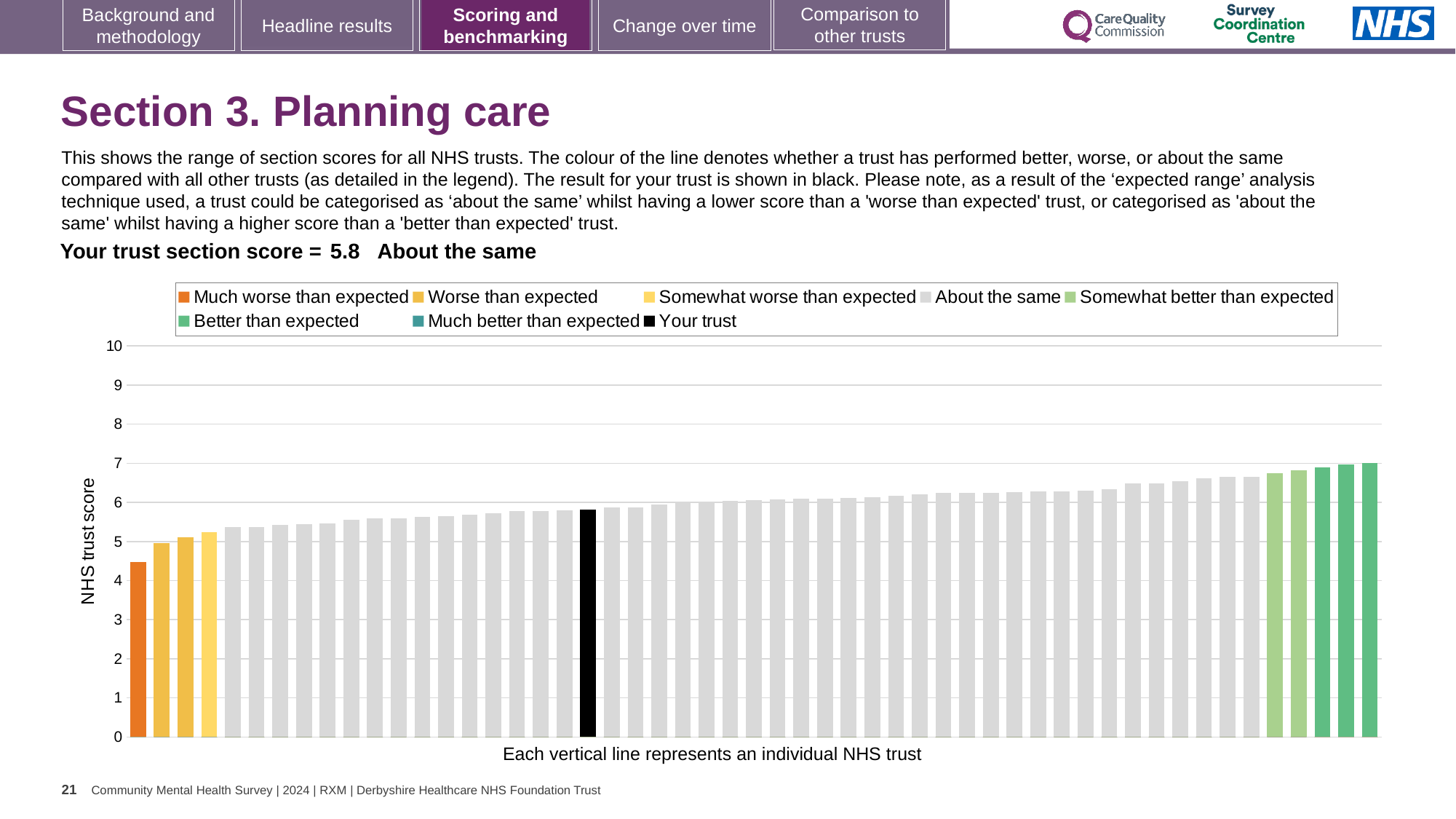
Is the lowest-scoring trust (the orange bar) greater or less than 4? greater Which performance category is your trust placed in for Section 3 Planning care? About the same Is the value for your trust (the black bar) greater or less than 6? less What is the label on the vertical axis of the chart? NHS trust score How many entries does the chart legend list? 8 What is the section score for your trust shown on the chart? 5.8 What colour is used for the bar representing your trust? Black Is the value for your trust (the black bar) greater or less than 5? greater What kind of chart is used to show the range of section scores? Bar chart Do the trust scores rise or fall moving from left to right along the x axis? Rise